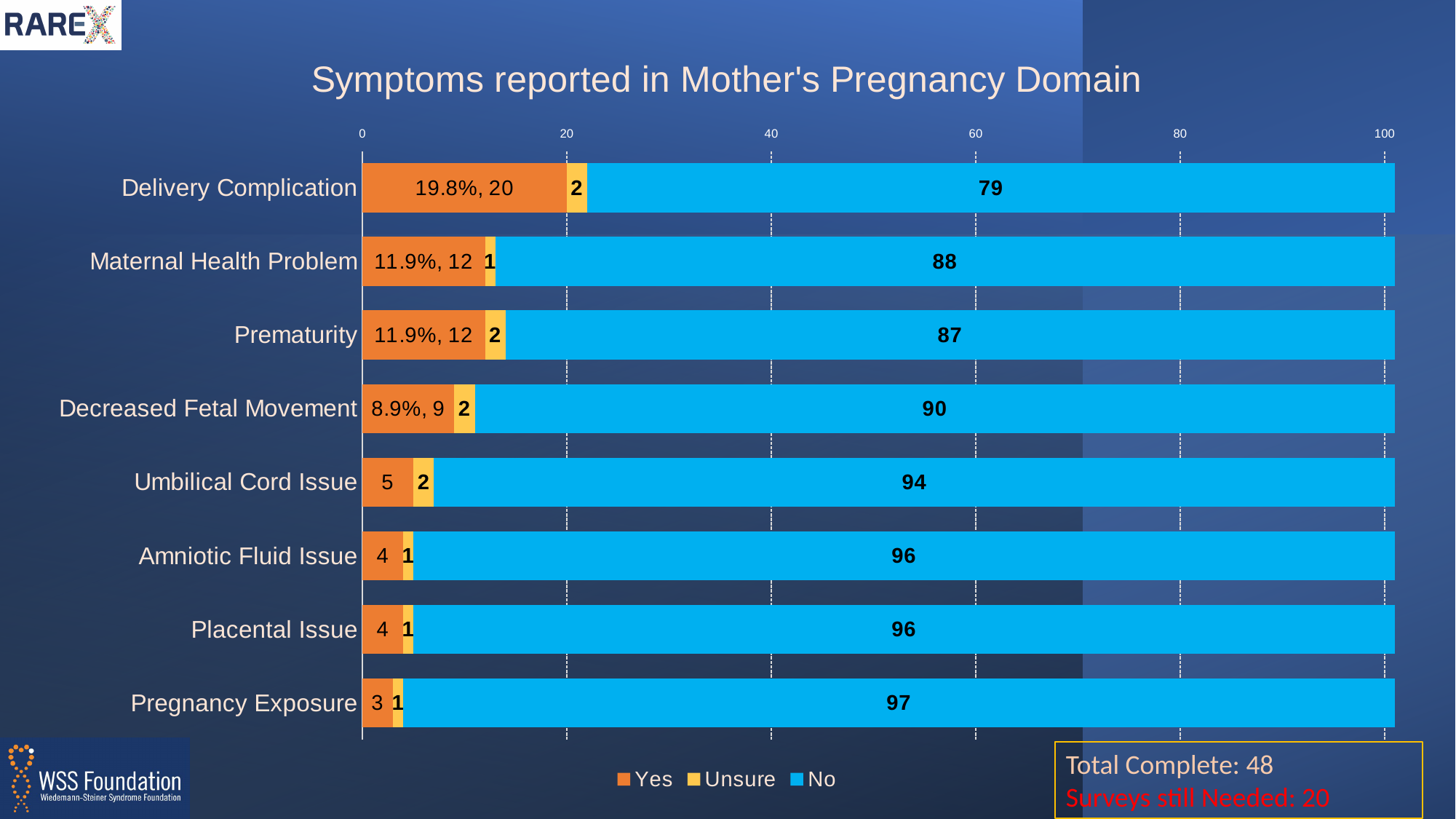
What kind of chart is shown on the slide? Stacked bar chart What is the title of the chart? Symptoms reported in Mother's Pregnancy Domain How many symptom categories are plotted on the chart? 8 Which category has the lowest 'Yes' value? Pregnancy Exposure How many series does the legend list? 3 What is the total of the stacked bar for Delivery Complication? 101 Which category has the highest 'Yes' value? Delivery Complication What is the 'No' value for Delivery Complication? 79 Which is larger, the 'Yes' value for Decreased Fetal Movement or for Umbilical Cord Issue? Decreased Fetal Movement What percentage is shown for 'Yes' on Maternal Health Problem? 11.9% What is the 'Unsure' value for Prematurity? 2 What is the difference between the 'No' values for Pregnancy Exposure and Delivery Complication? 18